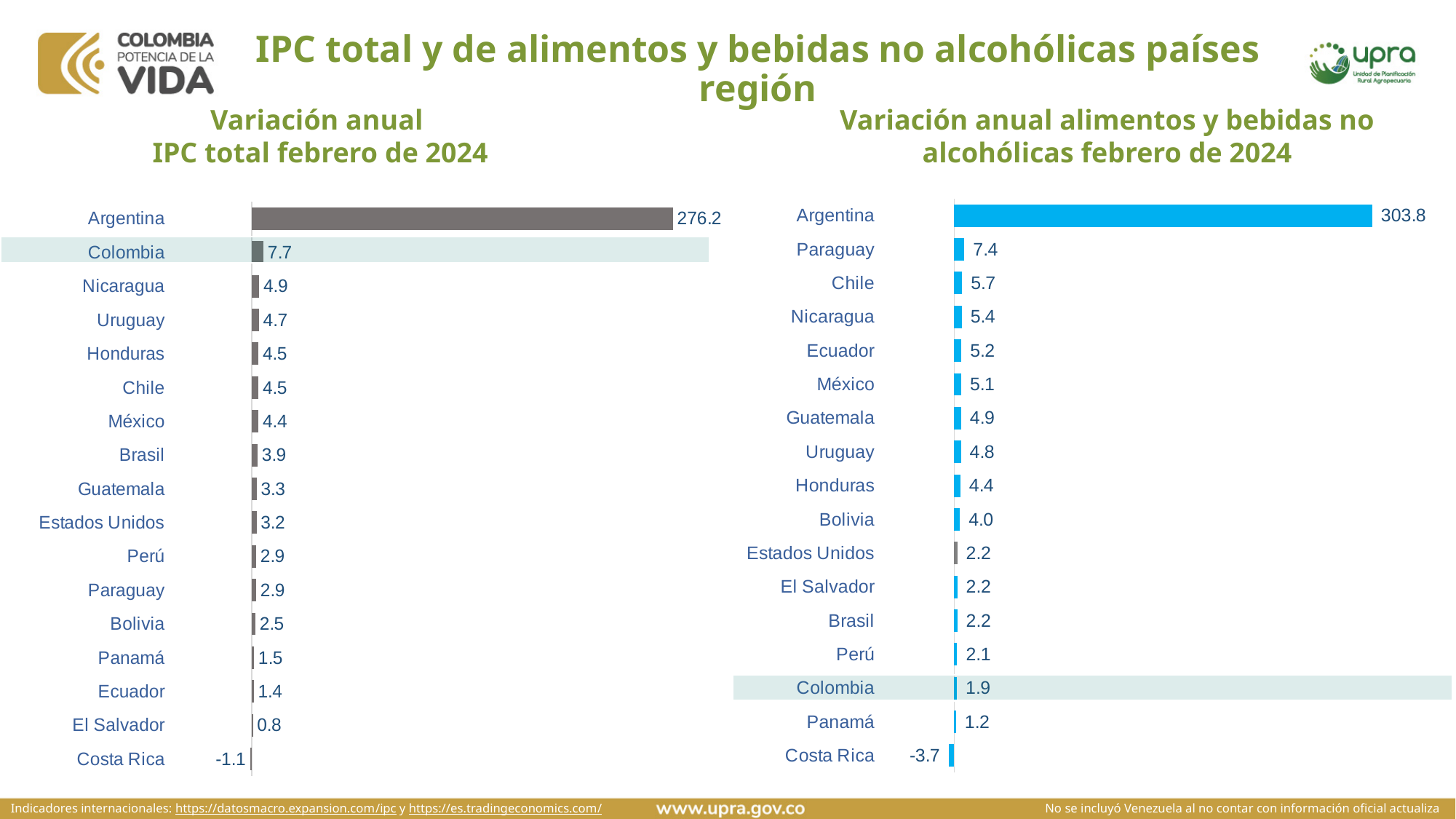
How many countries are shown in the left chart (Variación anual IPC total febrero de 2024)? 17 In the left chart (Variación anual IPC total febrero de 2024), what is the difference between the values for Nicaragua and Uruguay? 0.2 What kind of chart is the right chart (Variación anual alimentos y bebidas no alcohólicas febrero de 2024)? Bar chart In the left chart (Variación anual IPC total febrero de 2024), which country has the highest value? Argentina In the right chart (Variación anual alimentos y bebidas no alcohólicas febrero de 2024), what is the value for Colombia? 1.9 How many countries are shown in the right chart (Variación anual alimentos y bebidas no alcohólicas febrero de 2024)? 17 In the right chart (Variación anual alimentos y bebidas no alcohólicas febrero de 2024), what is the value for Argentina? 303.8 In the right chart (Variación anual alimentos y bebidas no alcohólicas febrero de 2024), which country has the lowest value? Costa Rica In the left chart (Variación anual IPC total febrero de 2024), what is the value for Costa Rica? -1.1 In the right chart (Variación anual alimentos y bebidas no alcohólicas febrero de 2024), which is larger, the value for Paraguay or the value for Chile? Paraguay In the left chart (Variación anual IPC total febrero de 2024), what is the difference between the values for Argentina and Colombia? 268.5 In the left chart (Variación anual IPC total febrero de 2024), what is the value for Colombia? 7.7